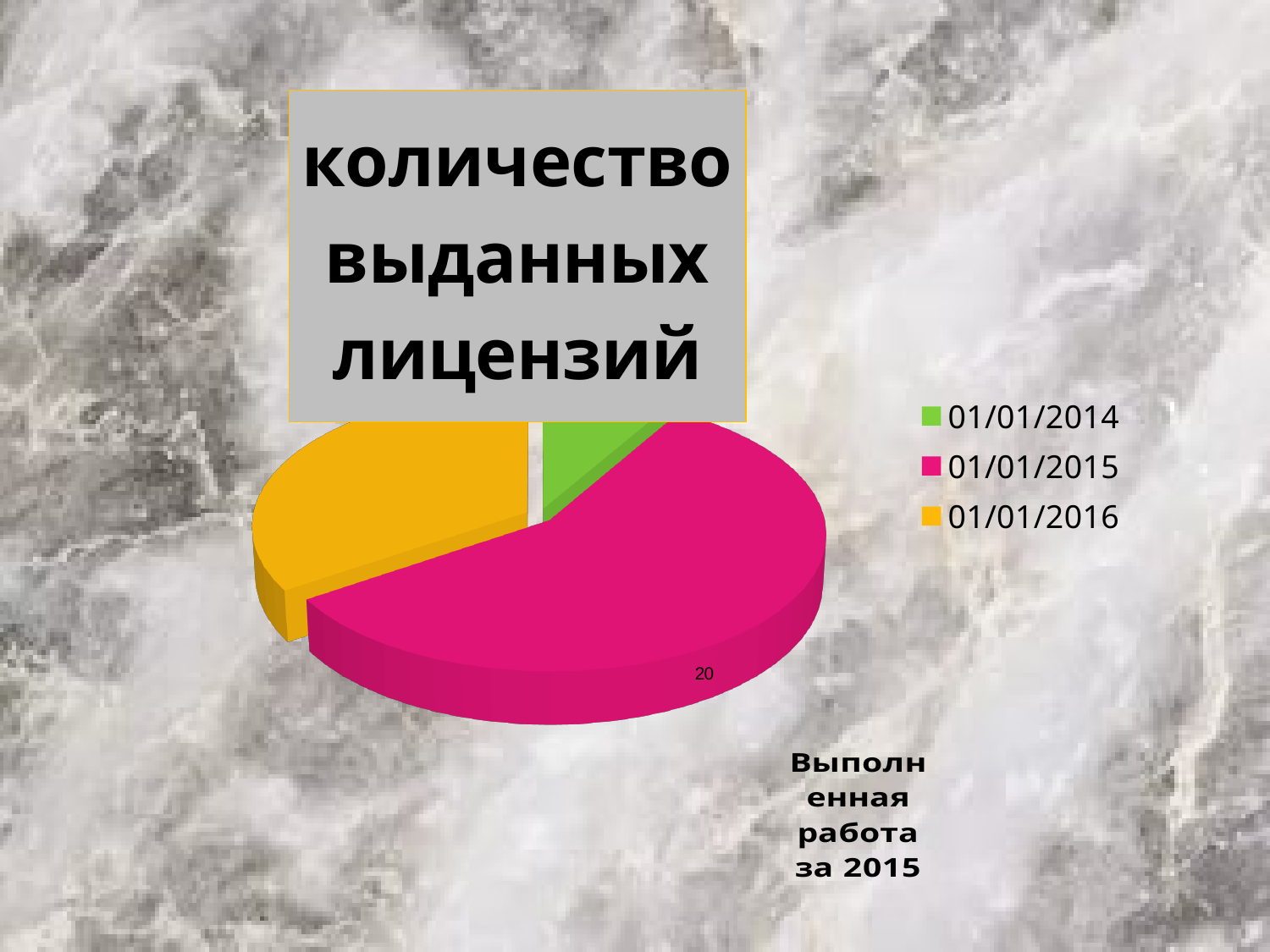
What is the title of the chart? количество выданных лицензий Which slice is larger, 01/01/2015 or 01/01/2016? 01/01/2015 How many slices does the pie chart have? 3 Which colour represents 01/01/2016 in the pie chart? yellow Which slice is larger, 01/01/2016 or 01/01/2014? 01/01/2016 How many entries does the chart legend list? 3 What value is labelled on the 01/01/2015 slice of the pie chart? 20 What kind of chart is shown on the slide? pie chart Which date has the smallest slice of the pie chart? 01/01/2014 Which date has the largest slice of the pie chart? 01/01/2015